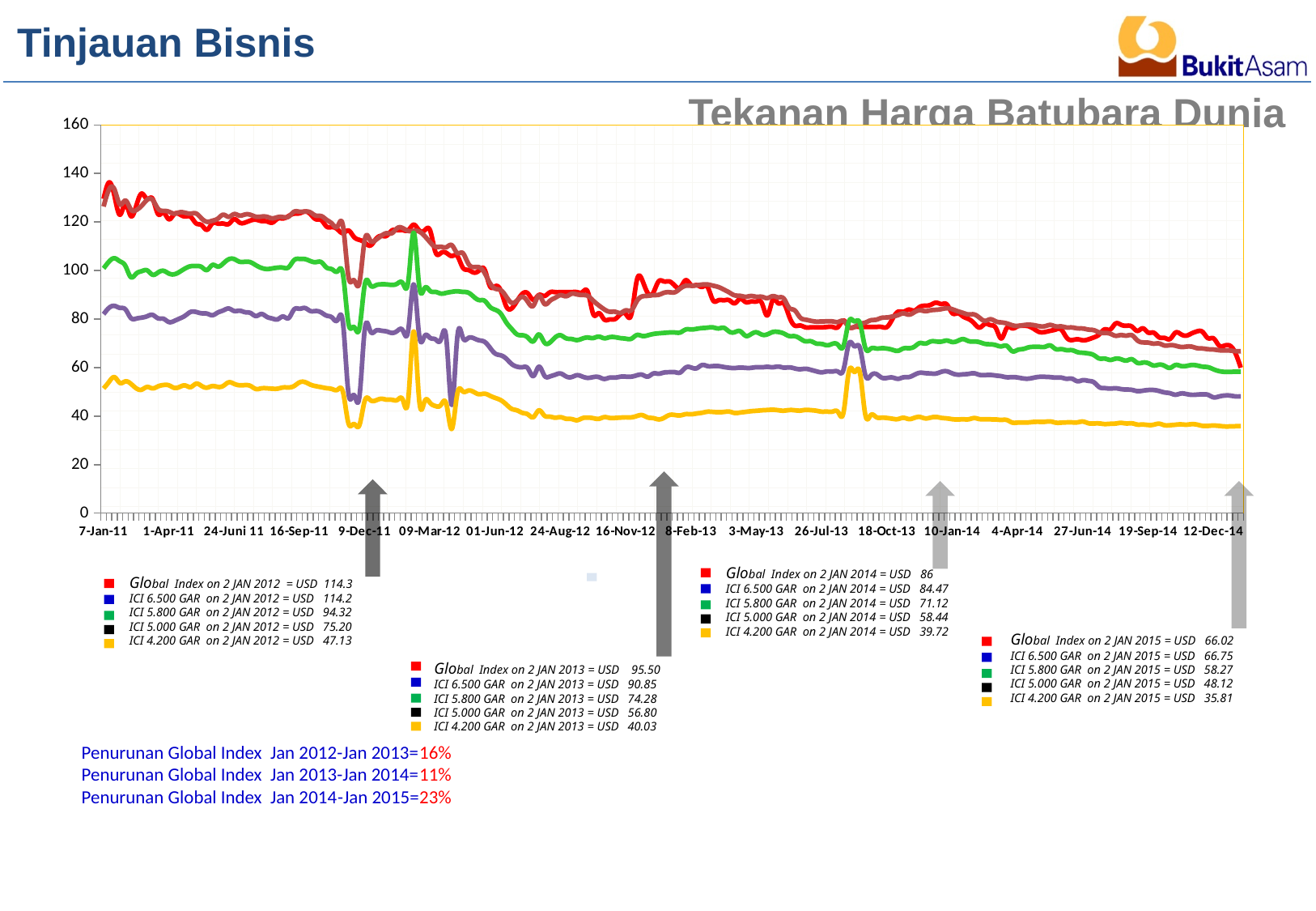
What was the Global Index on 2 JAN 2012 according to the annotation? USD 114.3 What is the difference between the Global Index on 2 JAN 2013 and on 2 JAN 2014? 9.50 Is the value of the yellow line at 12-Dec-14 greater or less than 40? less What is the title of the chart? Tekanan Harga Batubara Dunia Do the plotted price lines generally rise or fall from 7-Jan-11 to 12-Dec-14? fall How many price series are listed in each annotation box? 5 Is the value of the red line at 7-Jan-11 greater or less than 120? greater What was the ICI 4.200 GAR value on 2 JAN 2015? USD 35.81 Which series had the lowest value on 2 JAN 2012? ICI 4.200 GAR What kind of chart is shown on the slide? line chart On 2 JAN 2013, which was larger: ICI 6.500 GAR or ICI 5.800 GAR? ICI 6.500 GAR What was the ICI 5.800 GAR value on 2 JAN 2014? USD 71.12